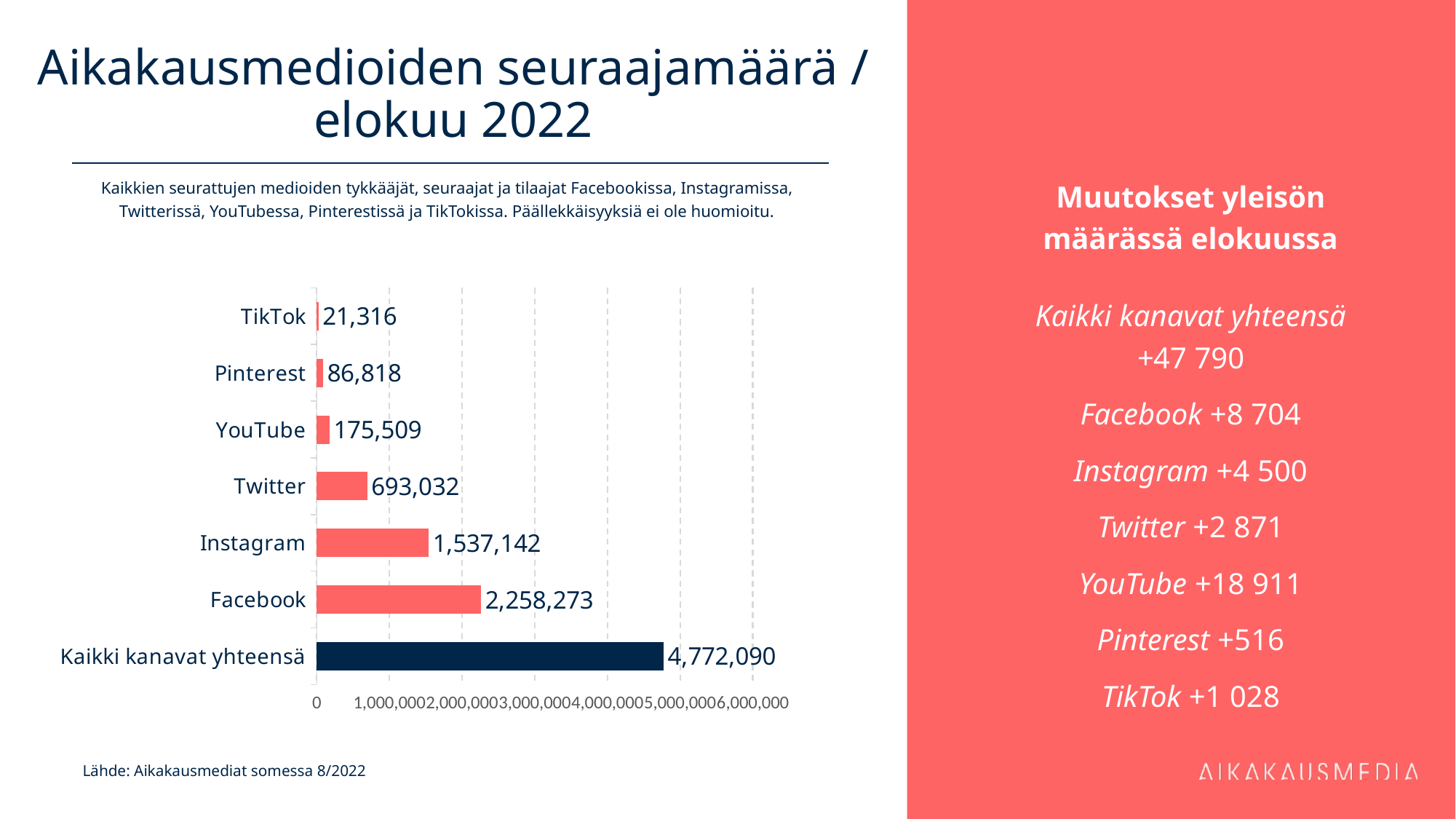
Which is larger, the value for YouTube or the value for Pinterest? YouTube What is the value for TikTok? 21,316 Is the value for Twitter greater or less than 1,000,000? less What is the value for Facebook? 2,258,273 Which individual channel (excluding the total) has the highest value? Facebook How many categories are shown in the chart? 7 What is the difference between the values for Twitter and YouTube? 517,523 What is the value for Kaikki kanavat yhteensä? 4,772,090 What is the difference between the values for Facebook and Instagram? 721,131 Which category has the lowest value? TikTok What kind of chart is shown on the slide? bar chart What is the value for Instagram? 1,537,142